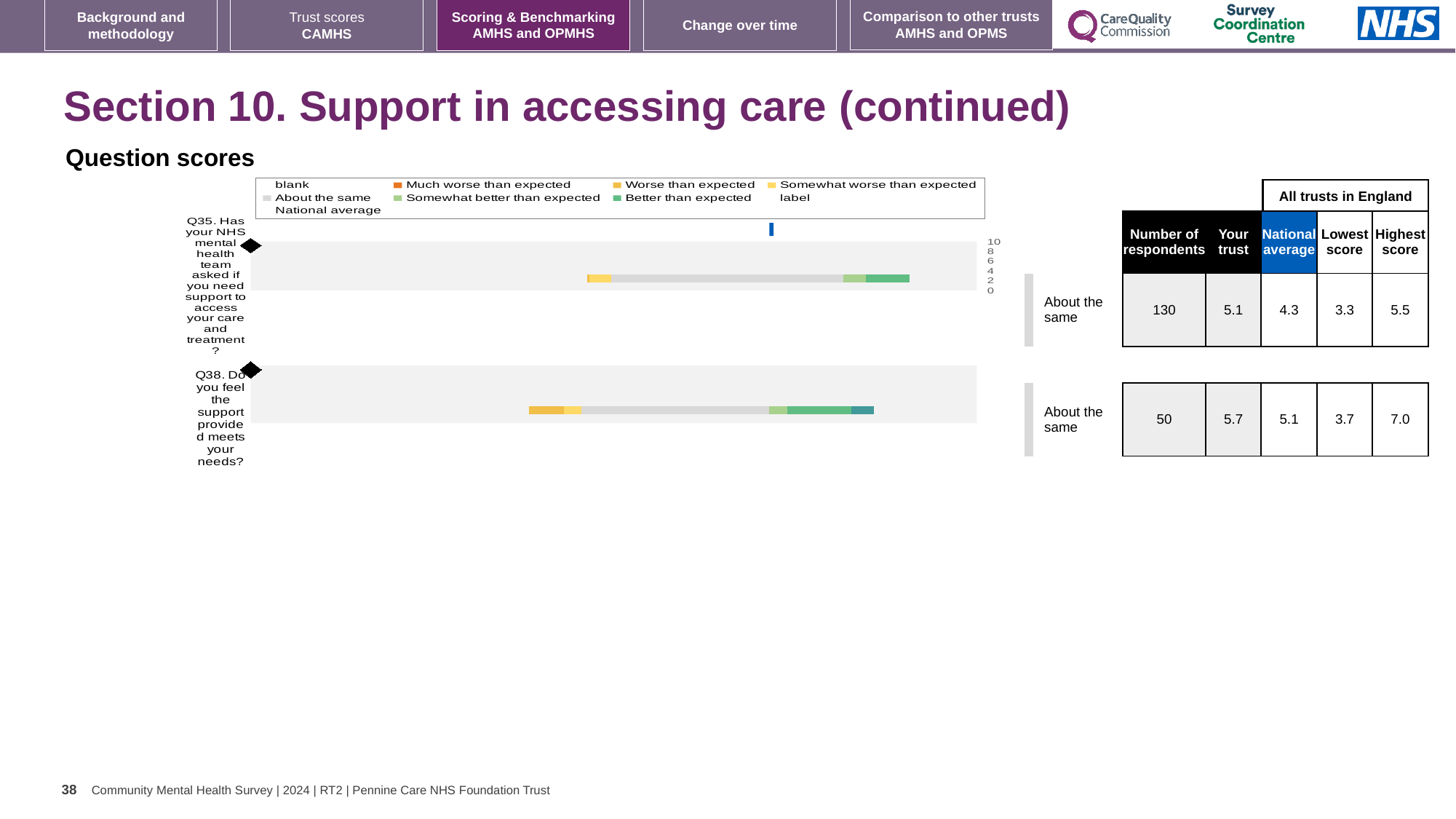
Which question has the higher 'Your trust' score, Q35 or Q38? Q38 What is the number of respondents shown for Q35 (Has your NHS mental health team asked if you need support to access your care and treatment?)? 130 What is the difference between the 'Your trust' score and the national average for Q35? 0.8 What kind of chart is shown on the slide? bar chart What is the national average score shown for Q35? 4.3 What is the 'Your trust' score shown for Q38 (Do you feel the support provided meets your needs?)? 5.7 How many questions (bars) are plotted in the chart? 2 What is the highest score among all trusts in England shown for Q38? 7.0 What benchmark category is shown for Q38 next to the chart? About the same How many entries does the chart legend list? 9 What is the lowest score among all trusts in England shown for Q35? 3.3 What is the difference between the highest and lowest scores for Q38? 3.3